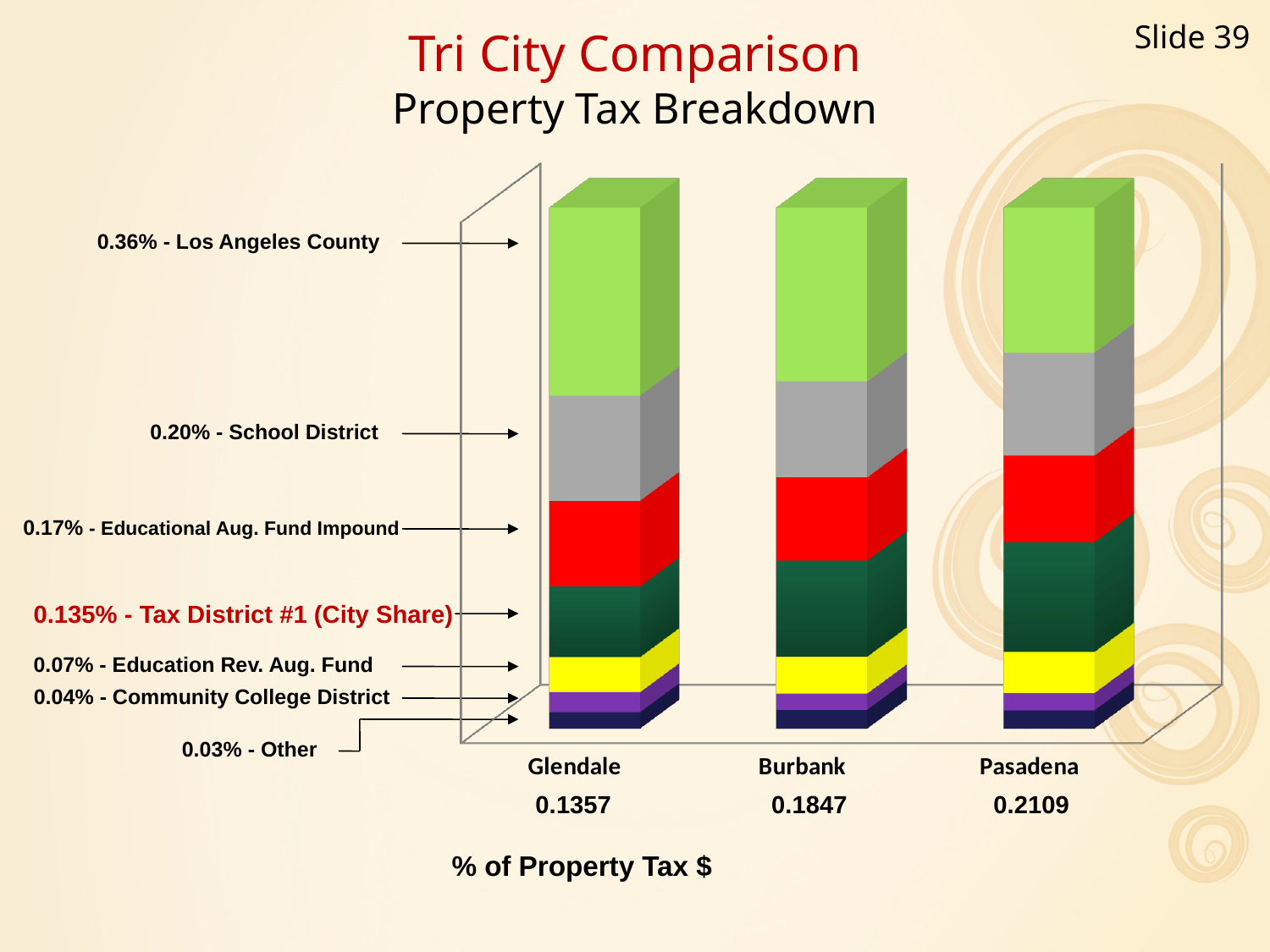
According to the labels on the left, what percentage goes to Los Angeles County? 0.36% Which city has the highest value printed below its bar? Pasadena According to the labels on the left, what percentage goes to Tax District #1 (City Share)? 0.135% What is the difference between the values printed below Pasadena and Glendale? 0.0752 What kind of chart is shown on the slide? Stacked bar chart What is the label on the horizontal axis of the chart? % of Property Tax $ Which city has the lowest value printed below its bar? Glendale What value is printed below Pasadena in the chart? 0.2109 How many cities are compared in the chart? 3 What value is printed below Burbank in the chart? 0.1847 What value is printed below Glendale in the chart? 0.1357 Which has the larger value printed below its bar, Burbank or Glendale? Burbank